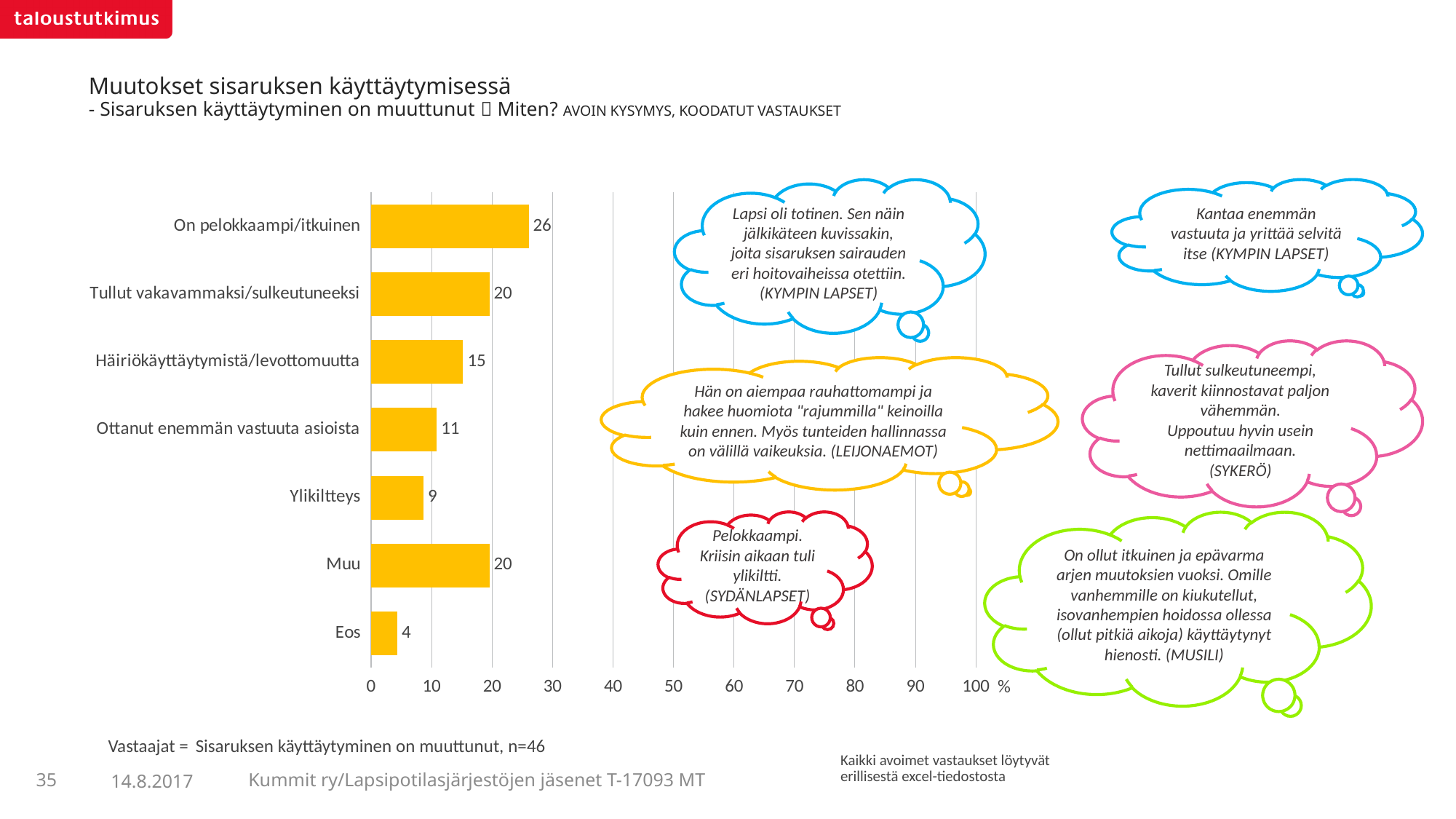
What is the value for "On pelokkaampi/itkuinen"? 26 How many categories are shown in the bar chart? 7 What is the difference between the values for "On pelokkaampi/itkuinen" and "Tullut vakavammaksi/sulkeutuneeksi"? 6 What is the difference between the values for "Häiriökäyttäytymistä/levottomuutta" and "Eos"? 11 What is the value for "Muu"? 20 Which is larger, the value for "Ottanut enemmän vastuuta asioista" or the value for "Ylikiltteys"? Ottanut enemmän vastuuta asioista Which category has the lowest value? Eos What is the value for "Häiriökäyttäytymistä/levottomuutta"? 15 What is the value for "Eos"? 4 What kind of chart is shown on the slide? Bar chart Which category has the highest value? On pelokkaampi/itkuinen What is the value for "Ylikiltteys"? 9